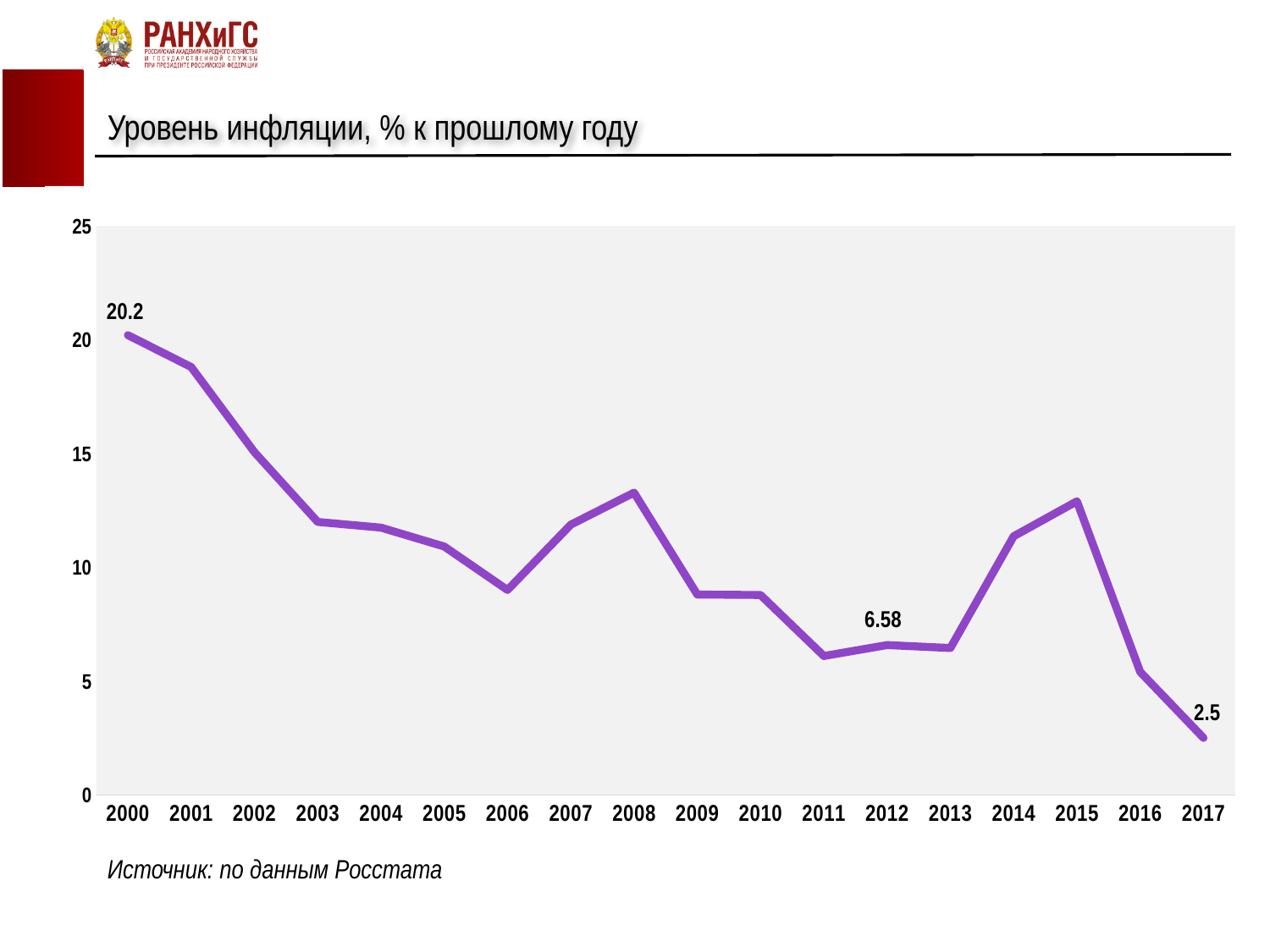
What is the inflation rate shown for 2017? 2.5 Which year has the highest inflation rate on the chart? 2000 Is the value for 2001 greater or less than 15? greater What type of chart is shown on the slide? Line chart By how much does the labelled value for 2000 exceed the labelled value for 2017? 17.7 How many years are plotted on the x axis? 18 What is the inflation rate shown for 2000? 20.2 Which year has the higher inflation rate, 2008 or 2009? 2008 Which year has the lowest inflation rate on the chart? 2017 What is the title of the chart? Уровень инфляции, % к прошлому году Is the value for 2011 greater or less than 10? less What value is labelled for 2012? 6.58